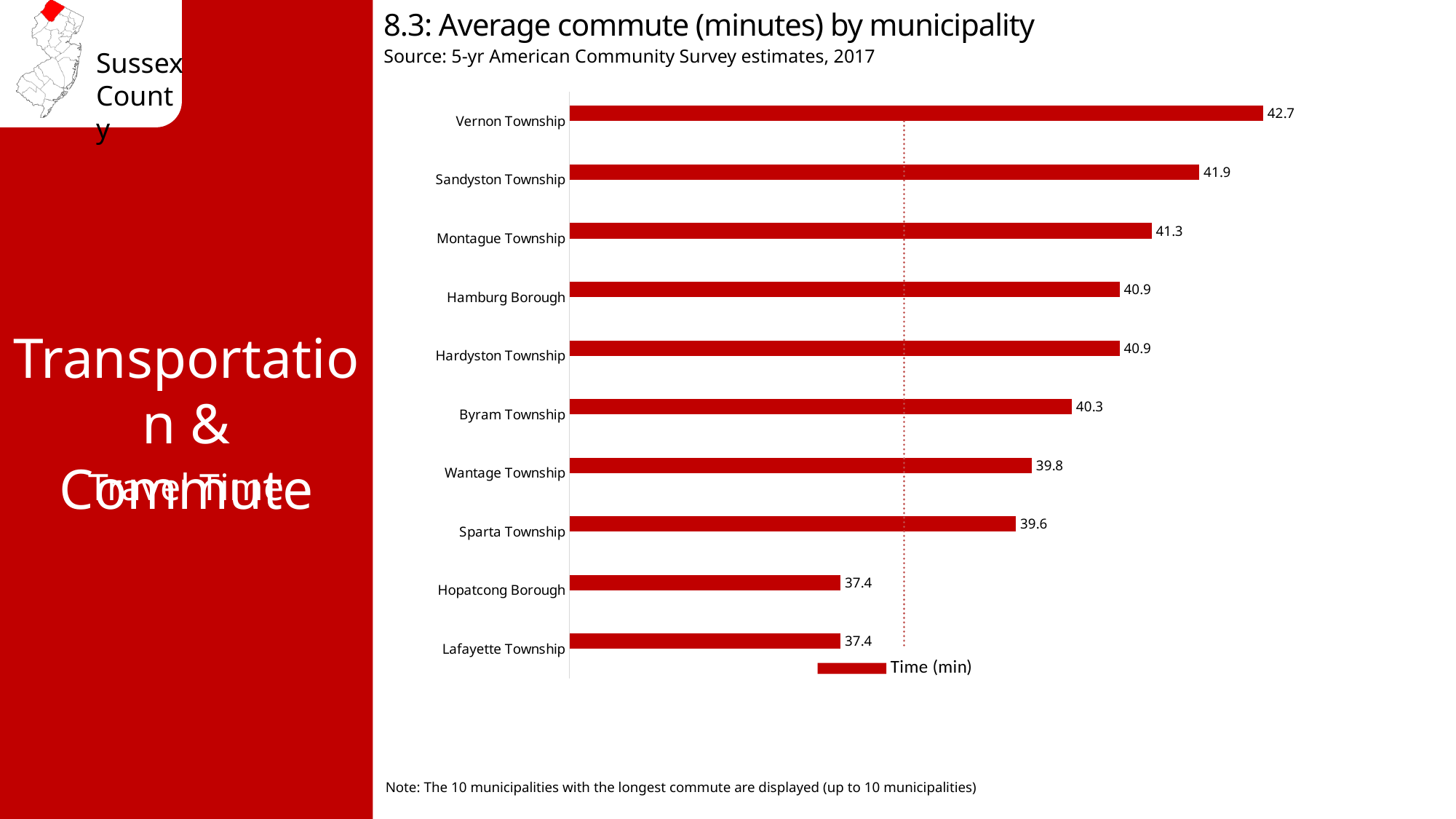
What is the difference in average commute time between Montague Township and Lafayette Township? 3.9 What type of chart is used to show average commute by municipality? Bar chart What is the difference in average commute time between Vernon Township and Sandyston Township? 0.8 How many municipalities are shown in the chart? 10 What is the legend entry for the series in the chart? Time (min) Which has a longer average commute, Wantage Township or Hopatcong Borough? Wantage Township Which has a longer average commute, Montague Township or Byram Township? Montague Township What is the average commute time for Vernon Township? 42.7 What is the average commute time for Sparta Township? 39.6 What is the average commute time for Byram Township? 40.3 Which municipality has the longest average commute? Vernon Township How many series does the legend list? 1